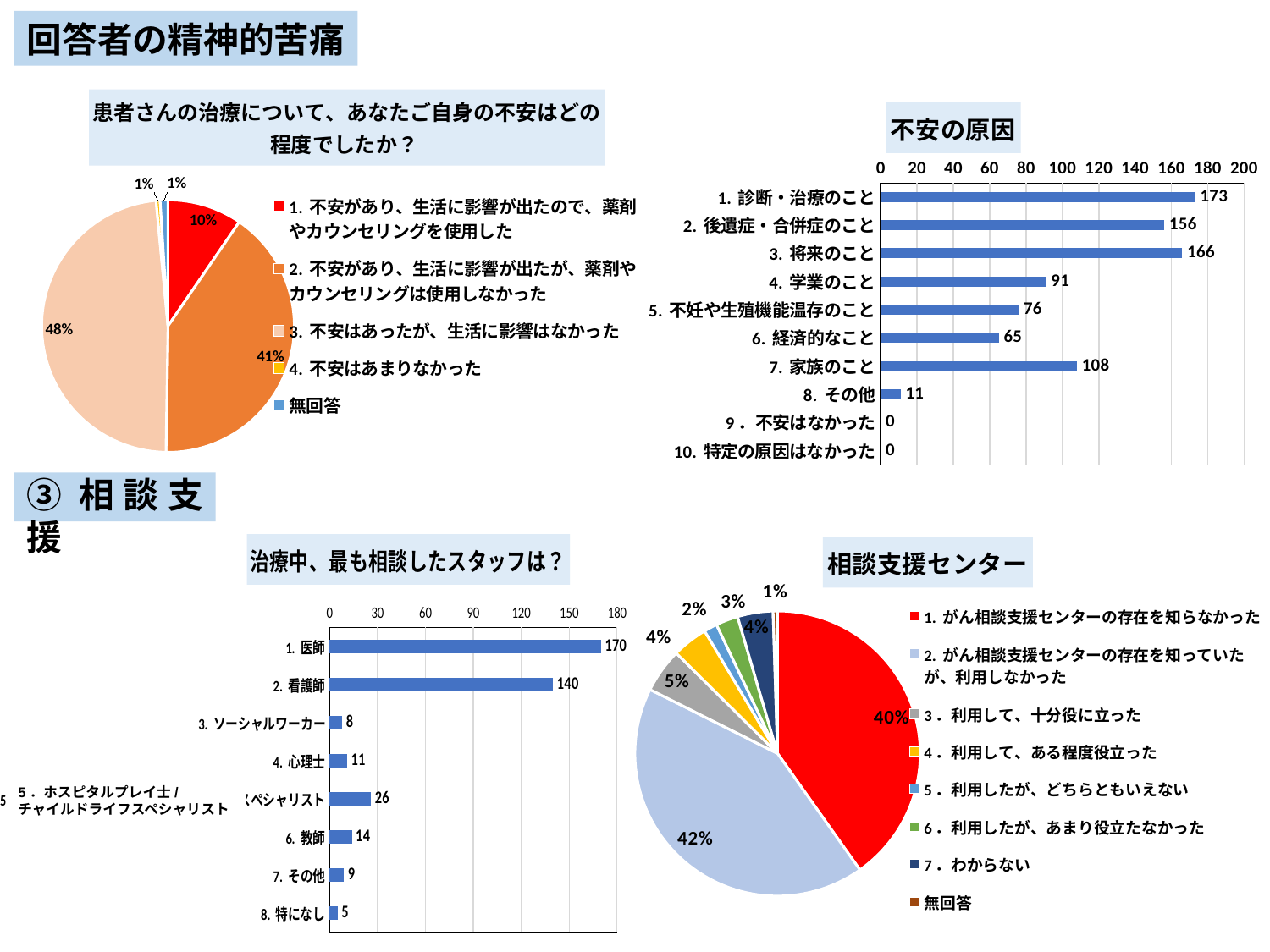
In the 治療中、最も相談したスタッフは？ chart, what is the value for 2. 看護師? 140 What kind of chart is 治療中、最も相談したスタッフは？? bar chart In the 不安の原因 chart, how many categories are shown? 10 In the 不安の原因 chart, what is the value for 1. 診断・治療のこと? 173 In the top-left pie chart (患者さんの治療について、あなたご自身の不安はどの程度でしたか？), what share does 3. 不安はあったが、生活に影響はなかった have? 48% How many entries does the legend of the 相談支援センター pie chart list? 8 In the 不安の原因 chart, what is the difference between 3. 将来のこと and 2. 後遺症・合併症のこと? 10 In the 相談支援センター pie chart, what share does 2. がん相談支援センターの存在を知っていたが、利用しなかった have? 42% In the 治療中、最も相談したスタッフは？ chart, which is larger, 4. 心理士 or 6. 教師? 6. 教師 In the 不安の原因 chart, which category has the highest value? 1. 診断・治療のこと In the 不安の原因 chart, is the value for 7. 家族のこと greater or less than 100? greater In the 治療中、最も相談したスタッフは？ chart, which category has the lowest value? 8. 特になし